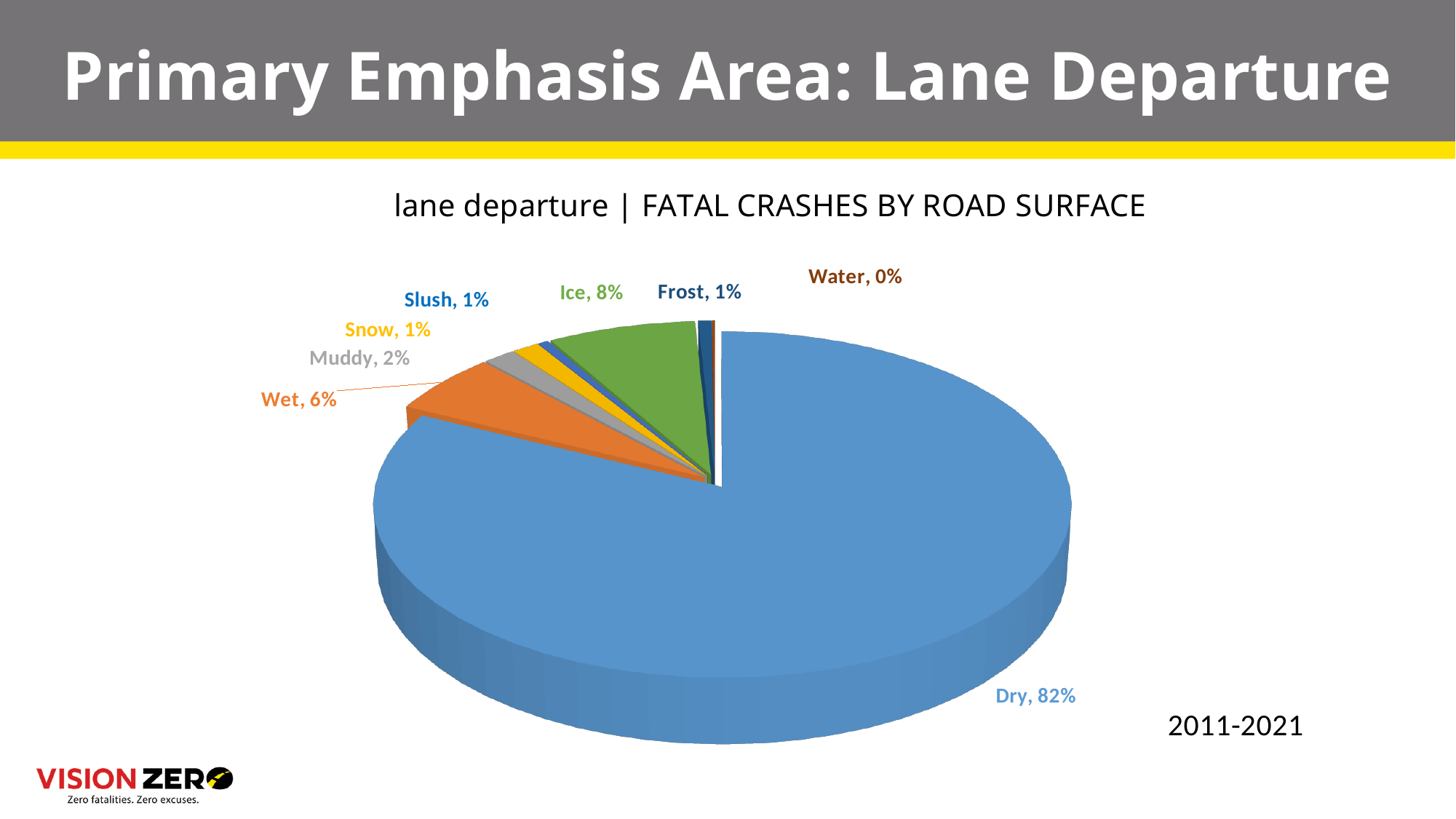
How many road surface categories are shown in the pie chart? 8 What type of chart is shown on the slide? Pie chart What share of lane departure fatal crashes occurred on dry road surfaces? 82% What percentage is shown for the Ice slice? 8% Which has a larger share of fatal crashes, Ice or Wet? Ice What percentage is shown for the Muddy road surface? 2% Which road surface accounts for the largest share of fatal crashes? Dry What percentage of fatal crashes is shown for wet road surfaces? 6% What is the title of the chart? lane departure | FATAL CRASHES BY ROAD SURFACE Which road surface has the smallest share of fatal crashes? Water What is the difference in percentage points between the Dry and Ice slices? 74 What year range does the chart cover? 2011-2021